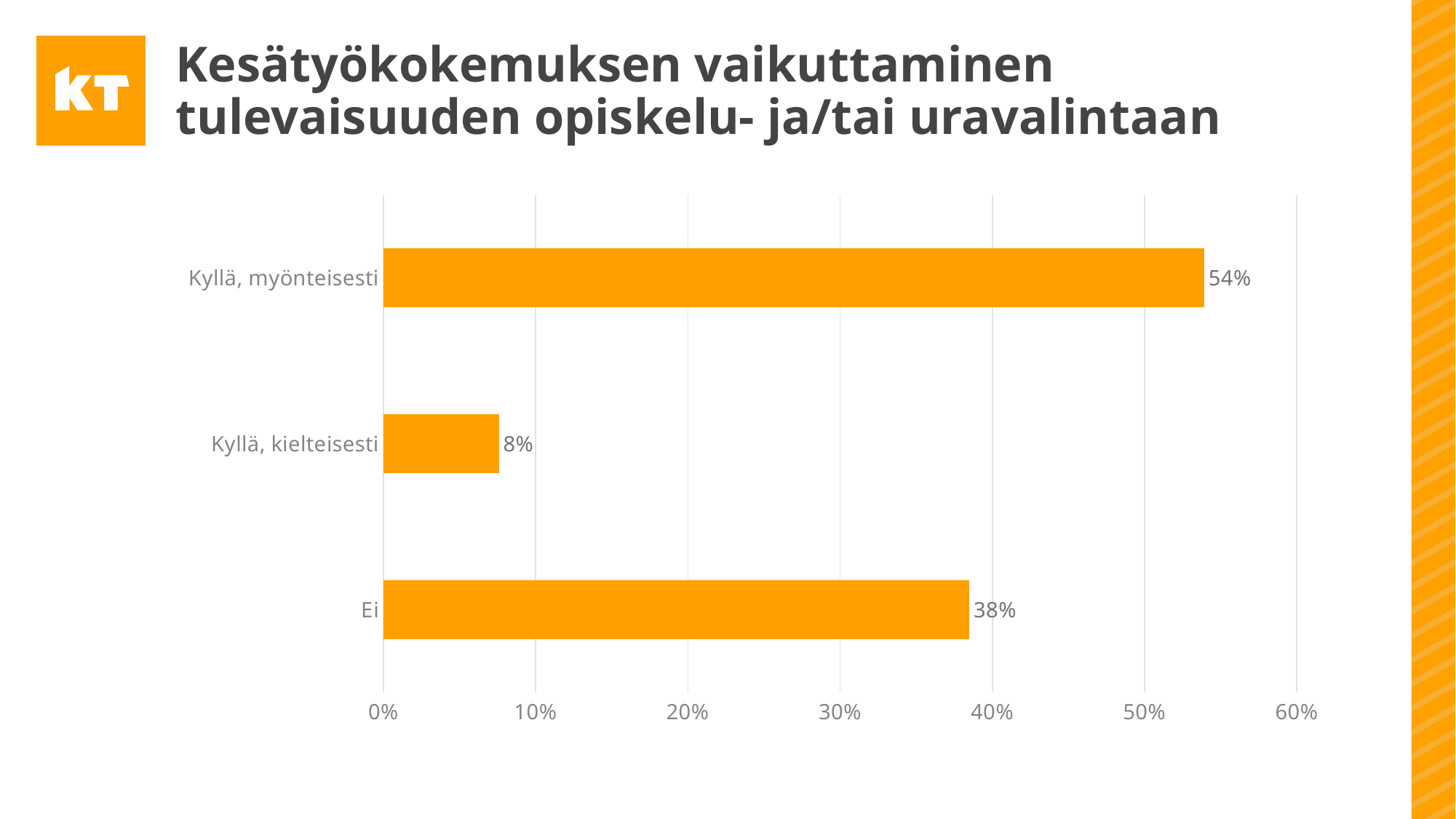
Which category has the lowest value? Kyllä, kielteisesti How many categories are shown in the chart? 3 What is the difference between the values for "Kyllä, myönteisesti" and "Ei"? 16% Which category has the highest value? Kyllä, myönteisesti What kind of chart is shown on the slide? bar chart What is the title of the slide? Kesätyökokemuksen vaikuttaminen tulevaisuuden opiskelu- ja/tai uravalintaan What is the value for "Kyllä, kielteisesti"? 8% What is the value for "Kyllä, myönteisesti"? 54% What is the difference between the values for "Ei" and "Kyllä, kielteisesti"? 30% Is the value for "Ei" greater or less than 40%? less Which is larger, the value for "Ei" or the value for "Kyllä, kielteisesti"? Ei What is the value for "Ei"? 38%